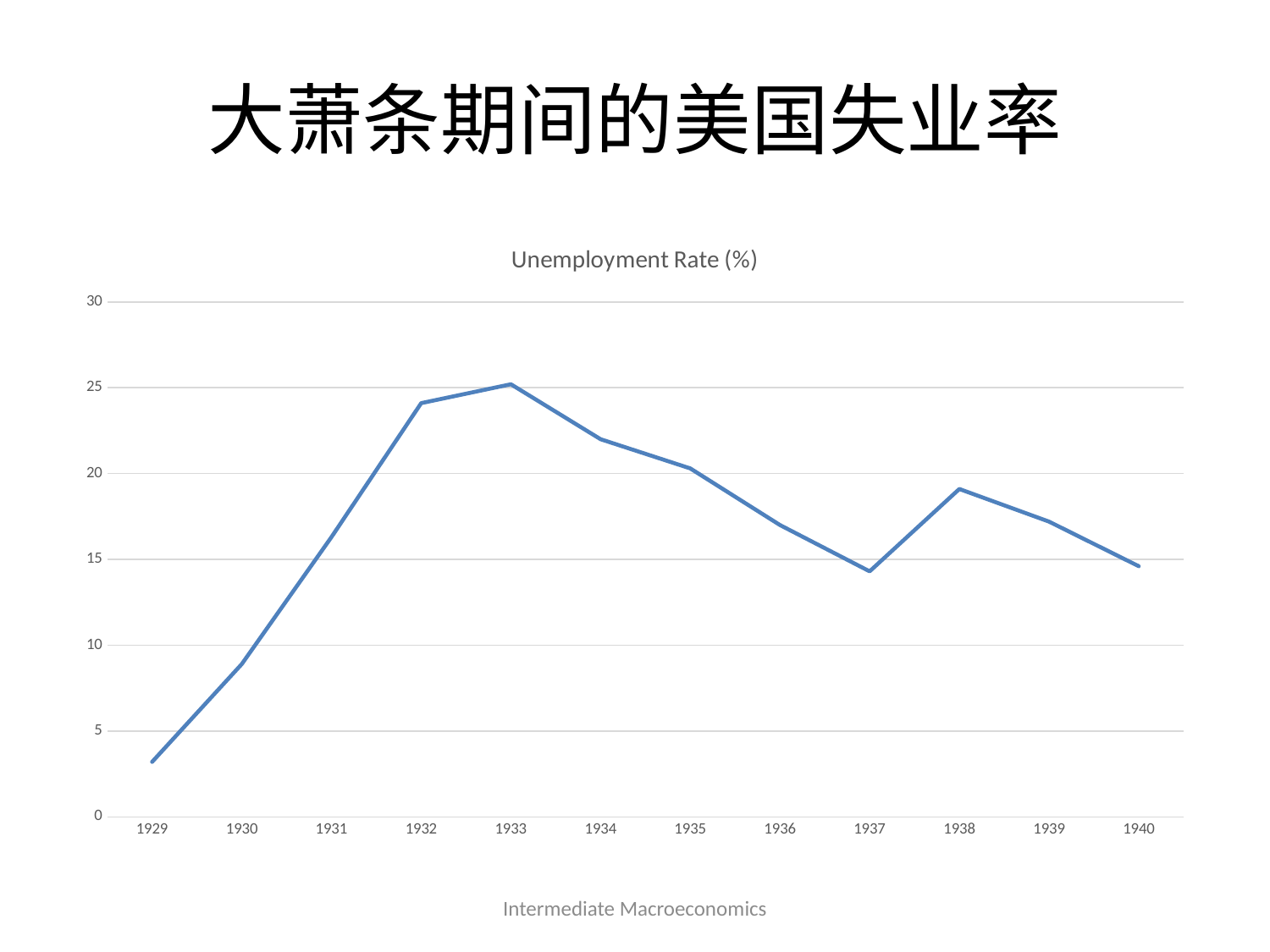
Which year has the highest unemployment rate? 1933 Is the unemployment rate for 1930 greater or less than 10? less Is the unemployment rate for 1932 greater or less than 20? greater Is the unemployment rate for 1929 greater or less than 5? less What kind of chart is shown on the slide? Line chart Which year has the lowest unemployment rate? 1929 How many years are plotted on the x axis? 12 Which year has a higher unemployment rate, 1932 or 1938? 1932 Does the unemployment rate rise or fall from 1929 to 1933? Rise What is the title of the chart? Unemployment Rate (%) Which year has a higher unemployment rate, 1937 or 1938? 1938